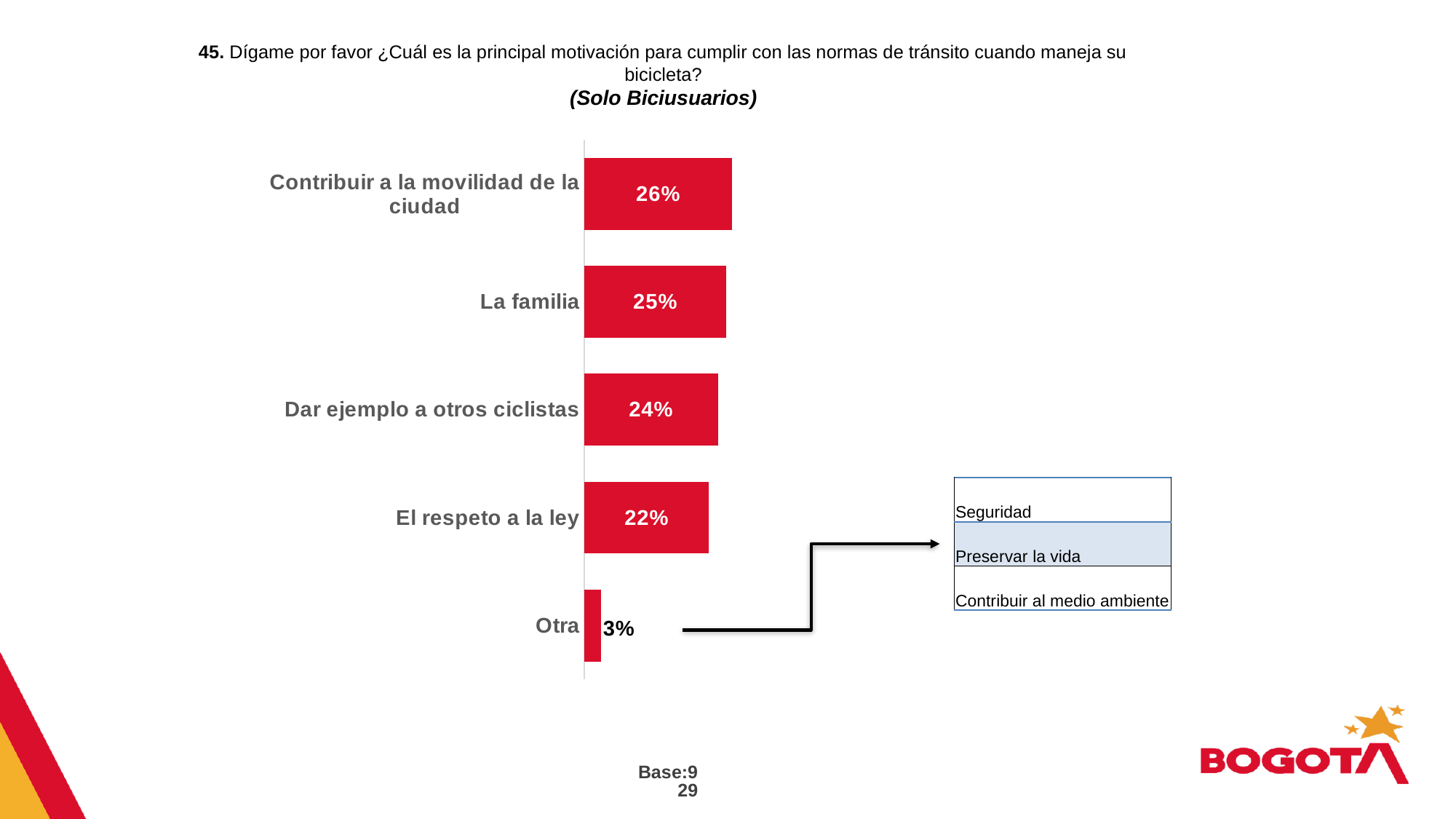
What is the value for "Contribuir a la movilidad de la ciudad"? 26% What is the difference between the values for "Contribuir a la movilidad de la ciudad" and "El respeto a la ley"? 4% How many categories are shown in the chart? 5 What is the value for "Otra"? 3% What is the difference between the values for "La familia" and "Otra"? 22% What is the value for "El respeto a la ley"? 22% Which is larger, the value for "Dar ejemplo a otros ciclistas" or the value for "Otra"? Dar ejemplo a otros ciclistas Which category has the lowest value? Otra What is the value for "Dar ejemplo a otros ciclistas"? 24% What kind of chart is shown on the slide? Bar chart What is the value for "La familia"? 25% Which category has the highest value? Contribuir a la movilidad de la ciudad